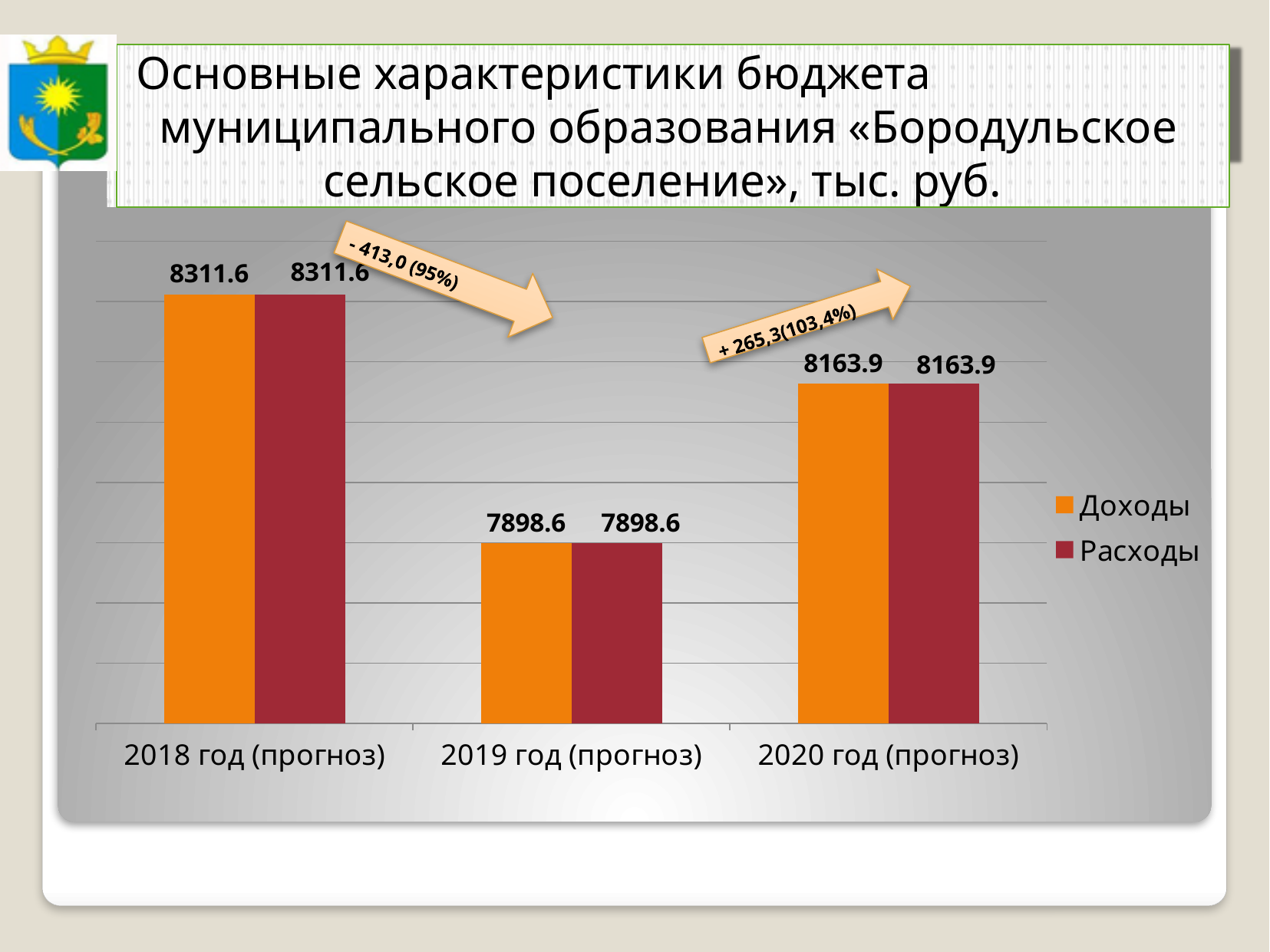
Which colour represents Расходы in the legend? Dark red What is the difference between Доходы in 2018 год (прогноз) and 2019 год (прогноз)? 413.0 What is the value of Доходы for 2020 год (прогноз)? 8163.9 What is the value of Расходы for 2019 год (прогноз)? 7898.6 Which is larger: Доходы in 2018 год (прогноз) or Доходы in 2020 год (прогноз)? 2018 год (прогноз) How many series does the legend list? 2 What is the value of Доходы for 2018 год (прогноз)? 8311.6 Which year has the highest value of Доходы? 2018 год (прогноз) How many years are shown on the x axis? 3 What is the difference between Расходы in 2020 год (прогноз) and 2019 год (прогноз)? 265.3 Which year has the lowest value of Расходы? 2019 год (прогноз) What kind of chart is shown on the slide? Bar chart